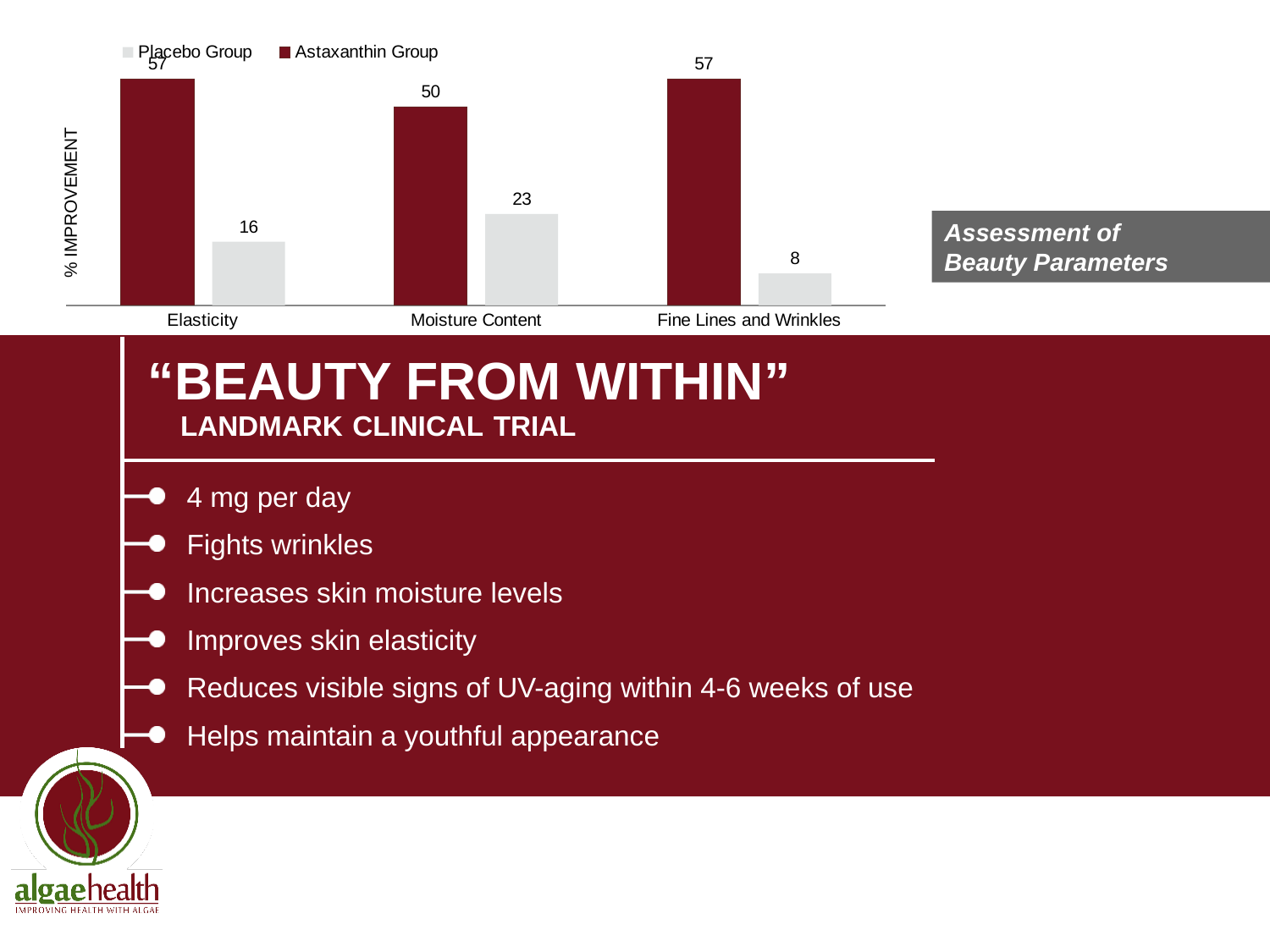
How many series does the chart legend list? 2 What is the value for the Placebo Group for Fine Lines and Wrinkles? 8 What is the difference between the Astaxanthin Group and Placebo Group values for Elasticity? 41 What is the value for the Astaxanthin Group for Moisture Content? 50 What kind of chart is shown on the slide? Bar chart What is the difference between the Astaxanthin Group and Placebo Group values for Fine Lines and Wrinkles? 49 Which is larger for Moisture Content: the Astaxanthin Group or the Placebo Group? Astaxanthin Group Which category has the lowest value for the Placebo Group? Fine Lines and Wrinkles Which category has the lowest value for the Astaxanthin Group? Moisture Content What is the value for the Placebo Group for Moisture Content? 23 What is the value for the Astaxanthin Group for Elasticity? 57 How many categories are shown on the x axis of the chart? 3